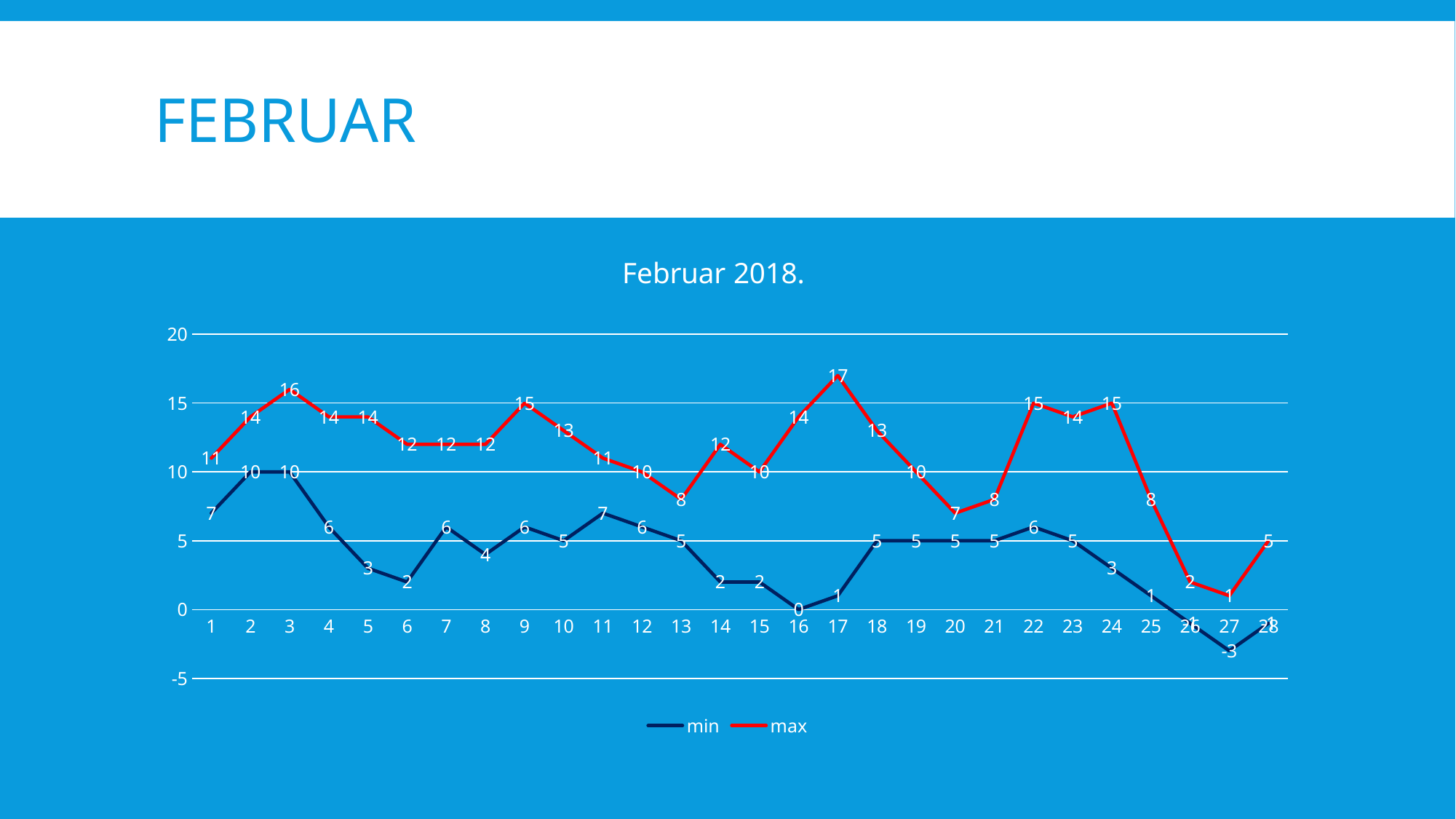
How many series does the legend list? 2 What is the title of the chart? Februar 2018. What is the difference between the max and min values on day 9? 9 What is the max value on day 3? 16 What type of chart is shown on the slide? line chart On which day is the min series lowest? 27 Which is larger, the max value on day 22 or the max value on day 25? day 22 On which day is the max series highest? 17 What is the min value on day 27? -3 What is the max value on day 17? 17 How many days are plotted along the x axis? 28 Does the max series rise or fall from day 24 to day 27? fall